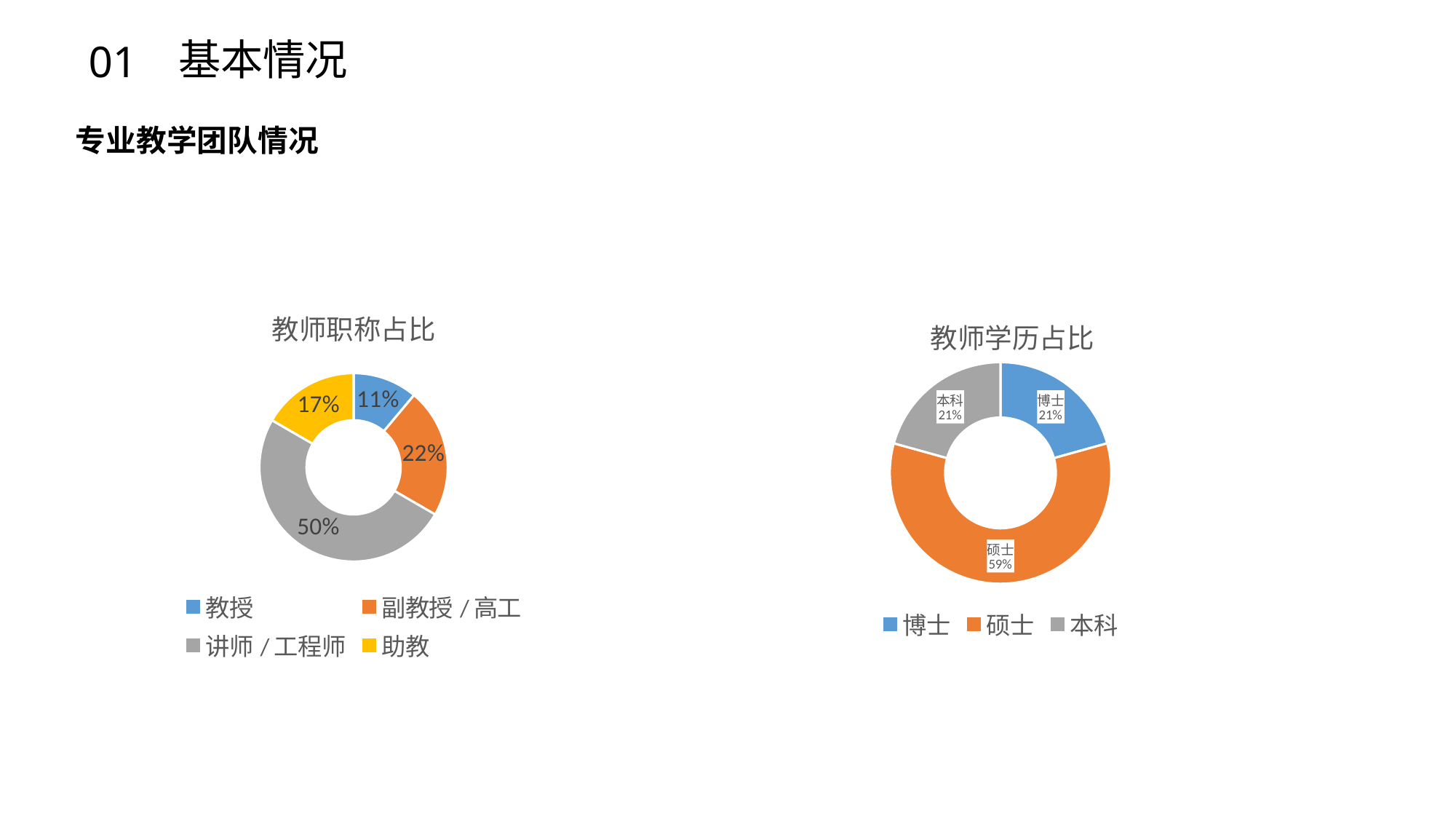
In the 教师学历占比 chart, which category has the largest share? 硕士 In the 教师职称占比 chart, which category has the smallest share? 教授 In the 教师职称占比 chart, what share does 讲师／工程师 have? 50% In the 教师职称占比 chart, which category has the largest share? 讲师／工程师 In the 教师学历占比 chart, what colour is the 硕士 slice? Orange In the 教师学历占比 chart, what is the difference between the shares of 硕士 and 本科? 38% In the 教师职称占比 chart, how many categories are shown? 4 In the 教师职称占比 chart, what is the difference between the shares of 副教授／高工 and 助教? 5% In the 教师职称占比 chart, what share does 教授 have? 11% In the 教师学历占比 chart, what share does 硕士 have? 59% What kind of chart is the 教师学历占比 chart? Doughnut (pie) chart